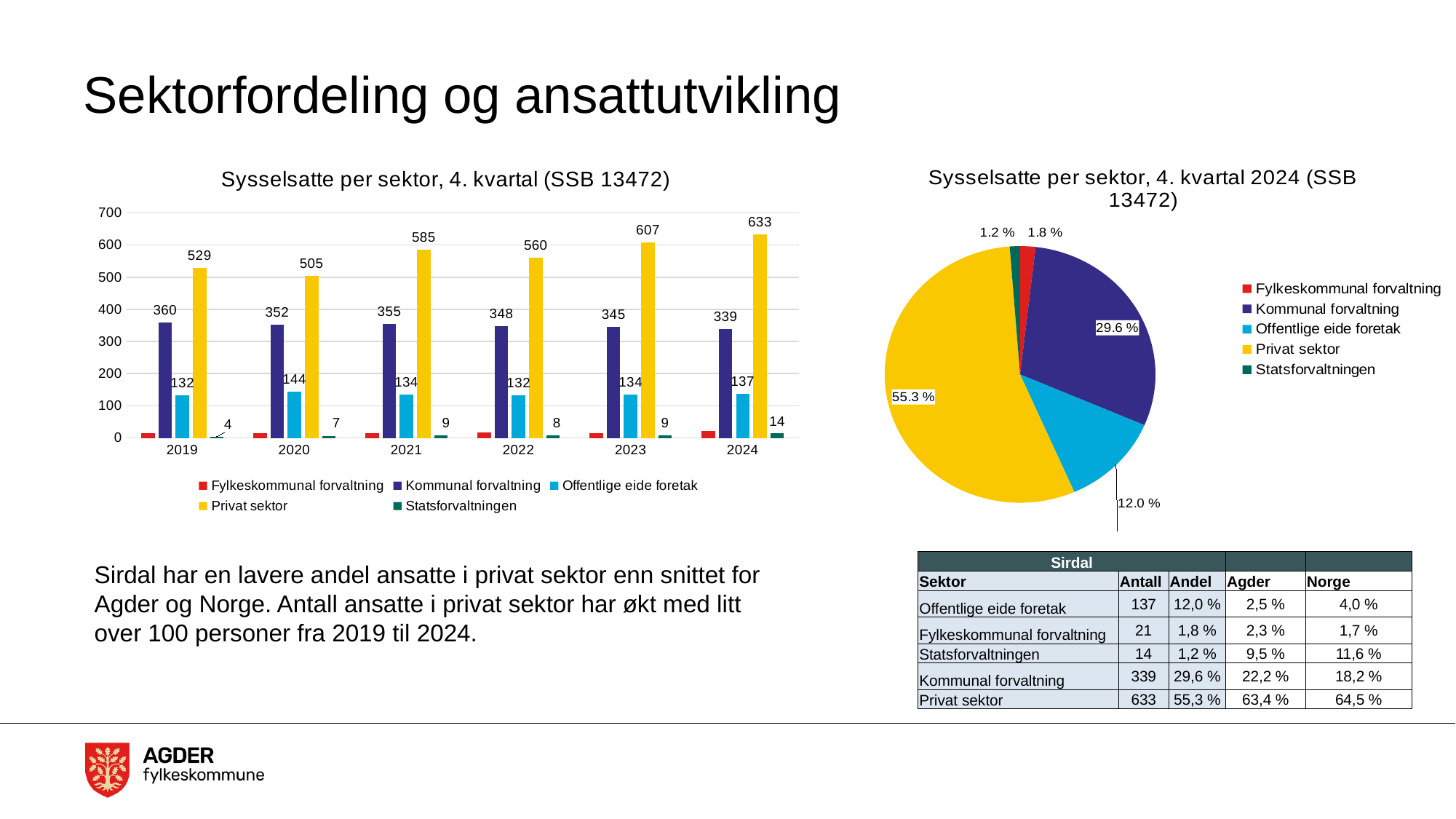
In the bar chart 'Sysselsatte per sektor, 4. kvartal (SSB 13472)', what is the value for Privat sektor in 2024? 633 In the pie chart 'Sysselsatte per sektor, 4. kvartal 2024 (SSB 13472)', what share does Privat sektor have? 55.3 % What kind of chart is the left chart 'Sysselsatte per sektor, 4. kvartal (SSB 13472)'? bar chart In the bar chart 'Sysselsatte per sektor, 4. kvartal (SSB 13472)', does Kommunal forvaltning rise or fall from 2019 to 2024? fall In the bar chart 'Sysselsatte per sektor, 4. kvartal (SSB 13472)', what is the value for Kommunal forvaltning in 2019? 360 How many series does the legend of the bar chart 'Sysselsatte per sektor, 4. kvartal (SSB 13472)' list? 5 In the bar chart 'Sysselsatte per sektor, 4. kvartal (SSB 13472)', in which year is Privat sektor highest? 2024 In the bar chart 'Sysselsatte per sektor, 4. kvartal (SSB 13472)', is Kommunal forvaltning larger in 2019 or in 2024? 2019 In the bar chart 'Sysselsatte per sektor, 4. kvartal (SSB 13472)', in which year is Privat sektor lowest? 2020 How many years are shown on the x axis of the bar chart 'Sysselsatte per sektor, 4. kvartal (SSB 13472)'? 6 In the bar chart 'Sysselsatte per sektor, 4. kvartal (SSB 13472)', by how much did Privat sektor increase from 2019 to 2024? 104 In the bar chart 'Sysselsatte per sektor, 4. kvartal (SSB 13472)', is the value for Fylkeskommunal forvaltning in 2024 greater or less than 100? less